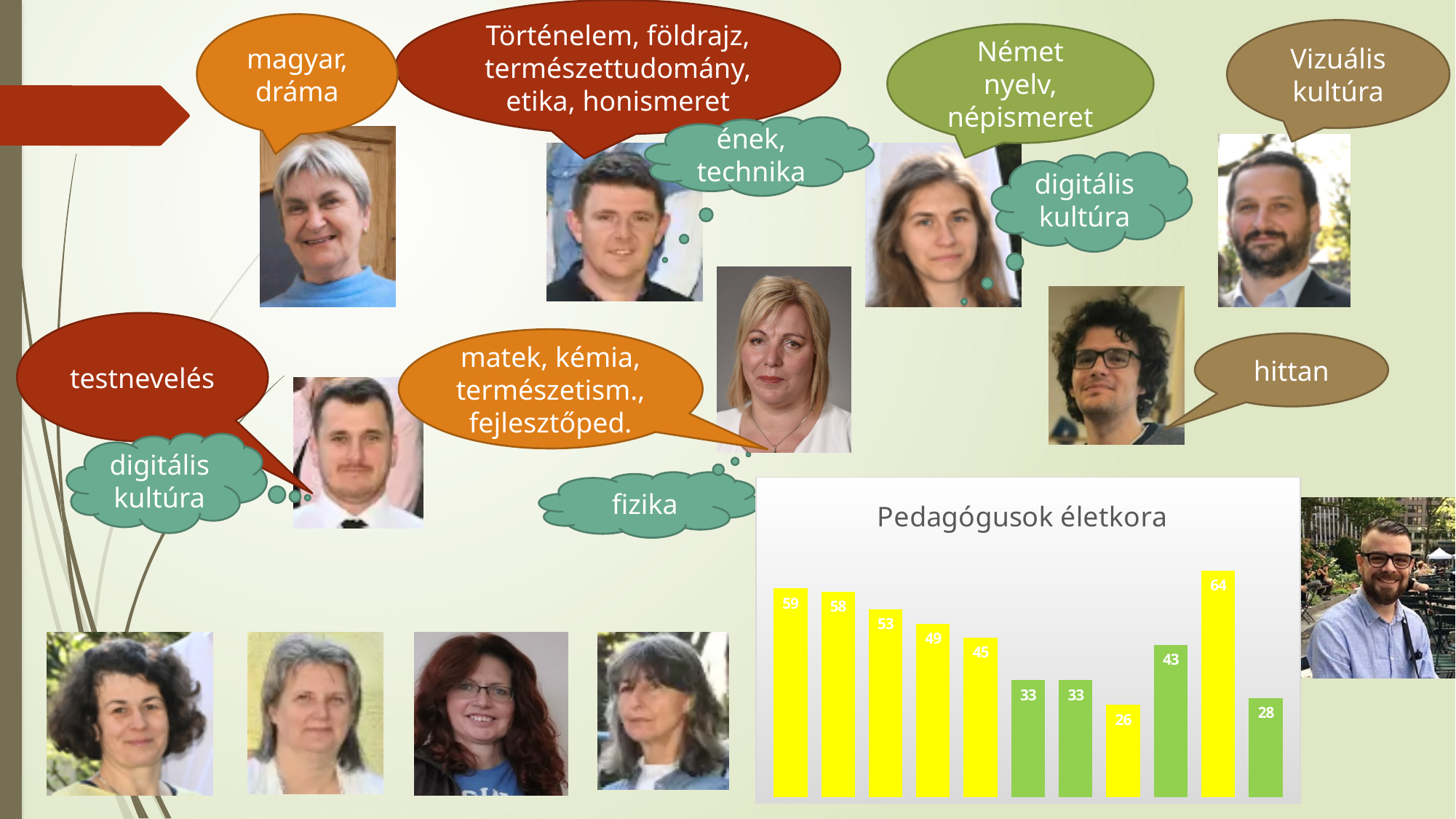
What is the title of the chart on the slide? Pedagógusok életkora What is the lowest value shown in the chart 'Pedagógusok életkora'? 26 What is the difference between the first bar (59) and the second bar (58) in the chart 'Pedagógusok életkora'? 1 What is the value of the third bar from the left in the chart 'Pedagógusok életkora'? 53 What is the highest value shown in the chart 'Pedagógusok életkora'? 64 How many bars does the chart 'Pedagógusok életkora' contain? 11 What is the difference between the highest and lowest values in the chart 'Pedagógusok életkora'? 38 What is the value of the last (rightmost) bar in the chart 'Pedagógusok életkora'? 28 What is the value of the first (leftmost) bar in the chart 'Pedagógusok életkora'? 59 In the chart 'Pedagógusok életkora', which is larger: the first bar (59) or the tenth bar (64)? the tenth bar (64) What two colours are used for the bars in the chart 'Pedagógusok életkora'? yellow and green What kind of chart is shown on the slide? bar chart